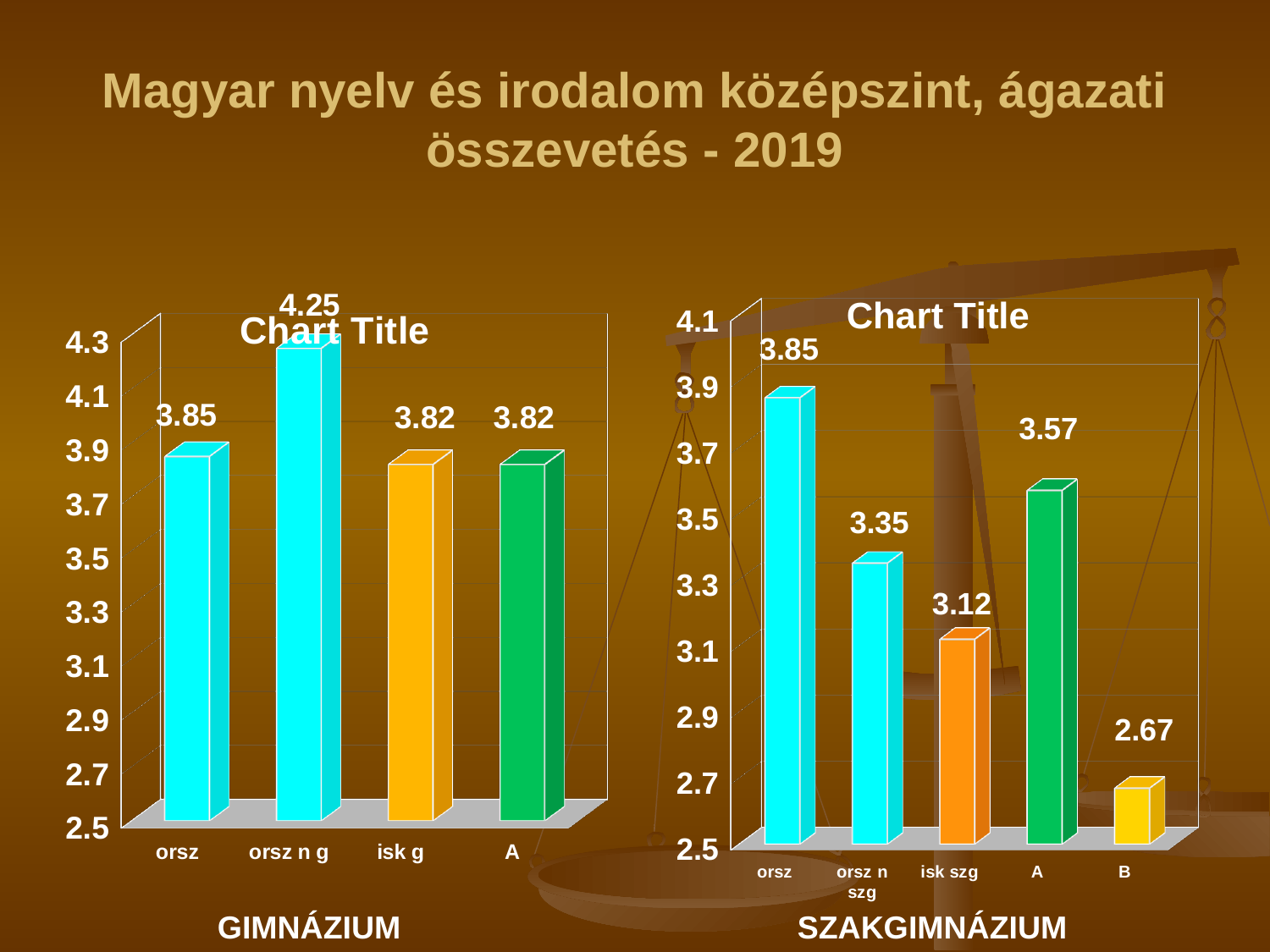
In the left chart (GIMNÁZIUM), how many bars are shown? 4 In the left chart (GIMNÁZIUM), what is the value for isk g? 3.82 In the left chart (GIMNÁZIUM), which category has the highest value? orsz n g In the right chart (SZAKGIMNÁZIUM), what is the value for isk szg? 3.12 In the right chart (SZAKGIMNÁZIUM), which category has the lowest value? B In the left chart (GIMNÁZIUM), what is the difference between orsz n g and orsz? 0.4 In the right chart (SZAKGIMNÁZIUM), which is larger, orsz n szg or A? A In the right chart (SZAKGIMNÁZIUM), what is the value for B? 2.67 What type of chart is the left chart (GIMNÁZIUM)? Bar chart In the right chart (SZAKGIMNÁZIUM), how many categories are shown? 5 In the right chart (SZAKGIMNÁZIUM), what is the difference between orsz and B? 1.18 In the left chart (GIMNÁZIUM), what is the value for orsz n g? 4.25